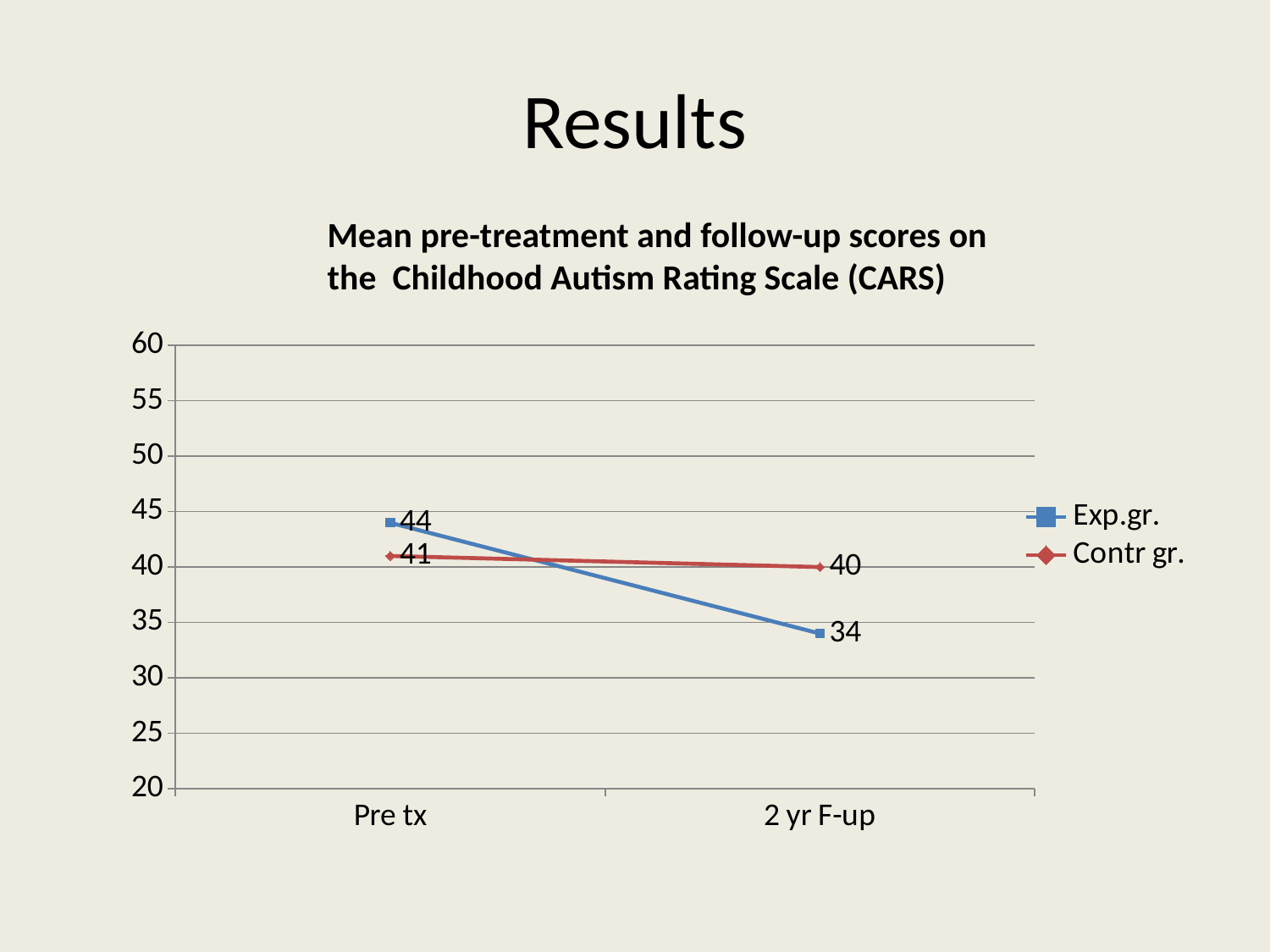
How many series does the legend list? 2 How many categories are shown on the x axis? 2 What is the Exp.gr. value at Pre tx? 44 What is the difference between the Exp.gr. and Contr gr. values at 2 yr F-up? 6 What kind of chart is shown? line chart Which series has the higher value at Pre tx, Exp.gr. or Contr gr.? Exp.gr. Which series has the lower value at 2 yr F-up? Exp.gr. Does the Exp.gr. series rise or fall from Pre tx to 2 yr F-up? fall What is the Contr gr. value at Pre tx? 41 What is the Exp.gr. value at 2 yr F-up? 34 What is the Contr gr. value at 2 yr F-up? 40 By how much did the Exp.gr. score change from Pre tx to 2 yr F-up? 10